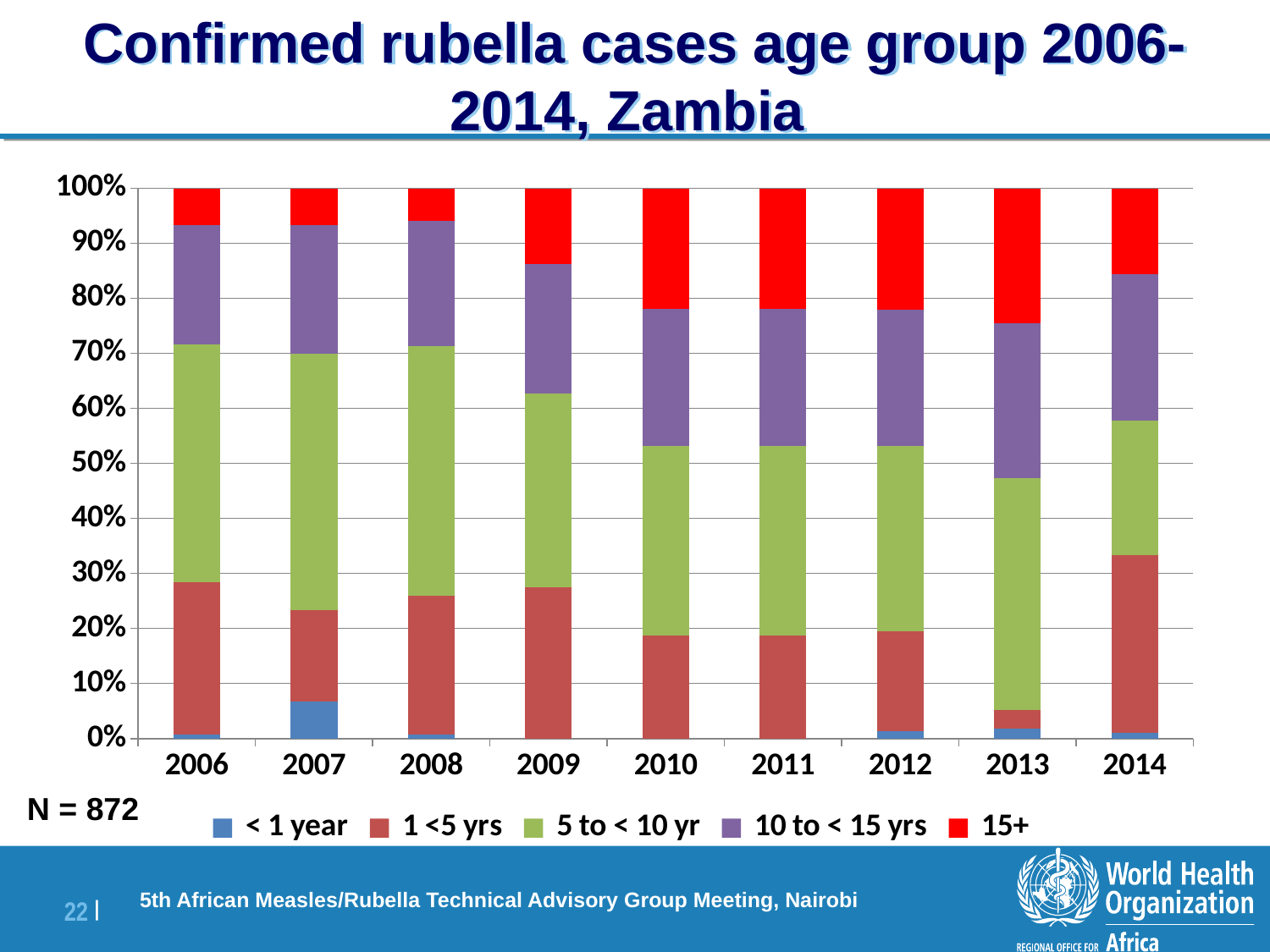
How many age-group series does the legend list? 5 How many years are shown on the x axis of the chart? 9 Is the share of < 1 year cases in 2007 greater or less than 10%? less Which year has the larger share of 15+ cases, 2006 or 2010? 2010 What total number of cases (N) is stated on the slide? N = 872 Which colour represents the 15+ age group in the legend? red Is the share of 15+ cases in 2013 greater or less than 20%? greater Is the share of 15+ cases in 2006 greater or less than 10%? less What kind of chart is shown on the slide? stacked bar chart Which year has the largest share of cases in the < 1 year age group? 2007 Which year has the smallest share of cases in the 1 <5 yrs age group? 2013